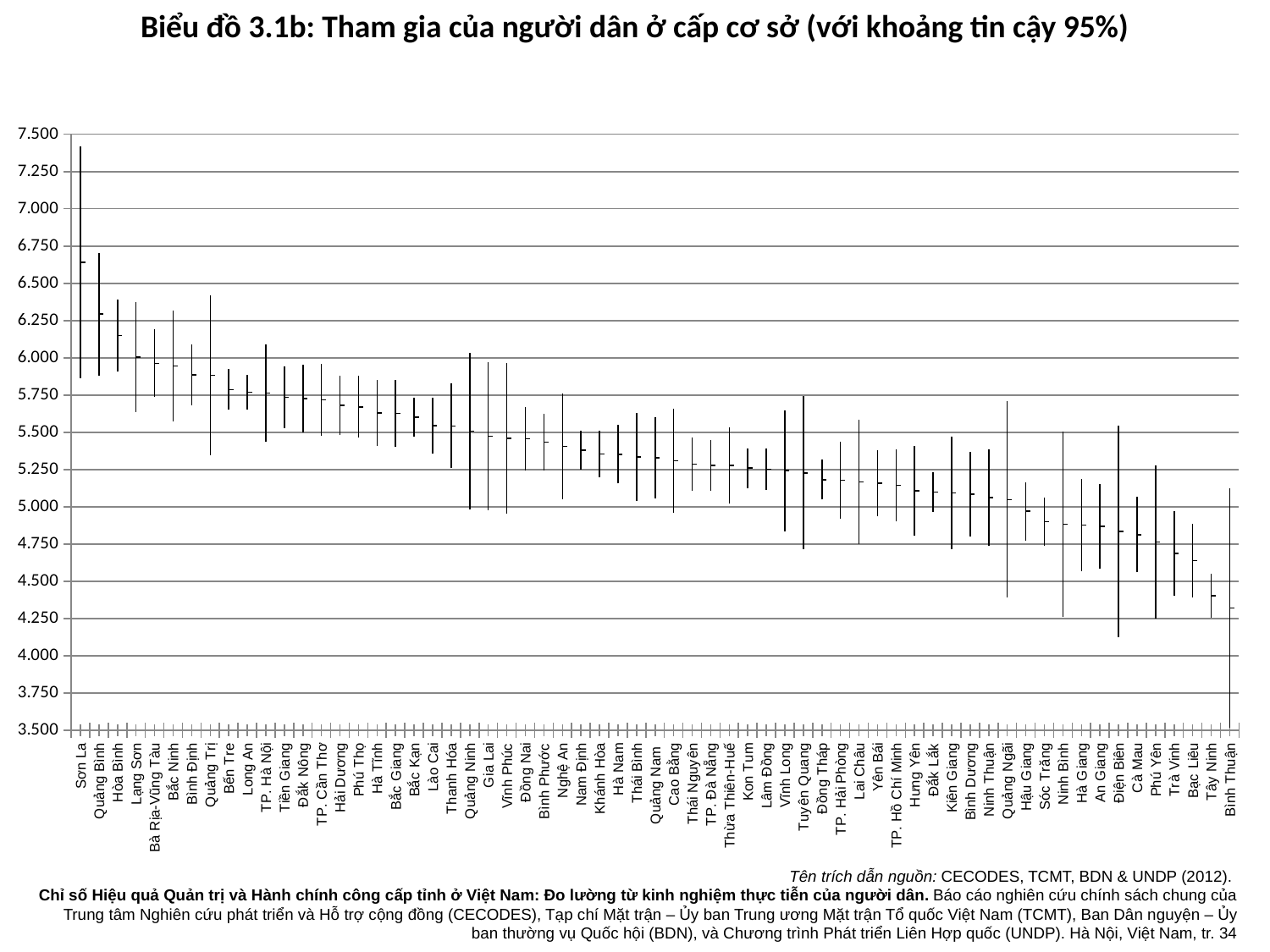
Is the value for Sơn La greater or less than 6.000? greater Do the values rise or fall moving from left to right along the x axis? fall What is the title of the chart? Biểu đồ 3.1b: Tham gia của người dân ở cấp cơ sở (với khoảng tin cậy 95%) Is the value for Tây Ninh greater or less than 4.750? less Which is larger, the value for Quảng Bình or the value for Tây Ninh? Quảng Bình How many provinces are shown along the x axis? 63 Which province has the lowest value on the chart? Bình Thuận What is the highest value shown on the y axis? 7.500 Is the value for Bến Tre greater or less than 5.500? greater Which province has the highest value on the chart? Sơn La